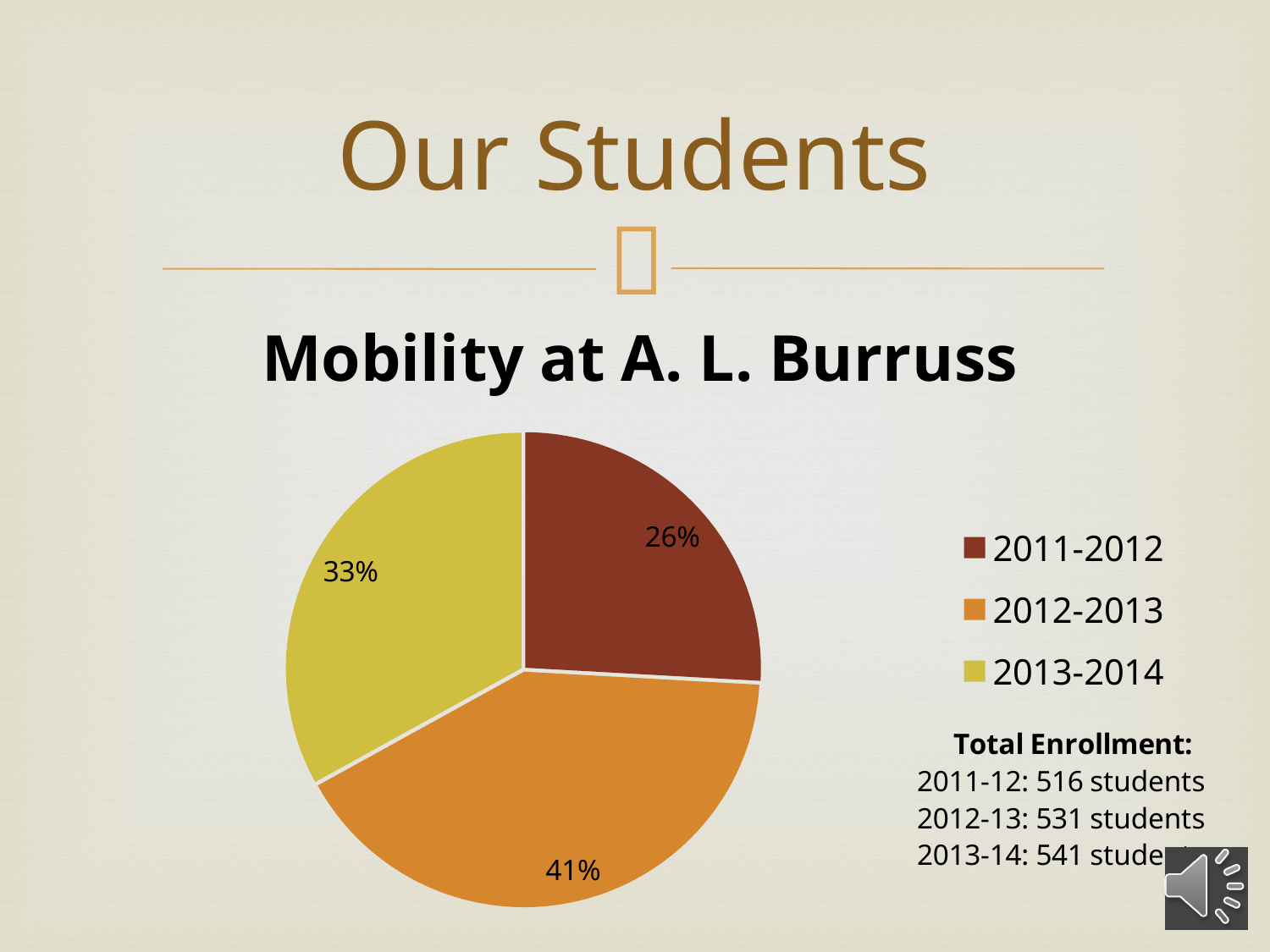
How many entries does the legend list? 3 What kind of chart is shown on the slide? pie chart What is the difference in percentage points between 2012-2013 and 2011-2012? 15 What percentage is shown for 2011-2012? 26% Which is larger, the slice for 2013-2014 or the slice for 2011-2012? 2013-2014 How many slices does the pie chart have? 3 What percentage is shown for 2012-2013? 41% What is the title of the chart? Mobility at A. L. Burruss What percentage is shown for 2013-2014? 33% What colour is the slice for 2013-2014? yellow Which year has the smallest slice of the pie? 2011-2012 Which year has the largest slice of the pie? 2012-2013